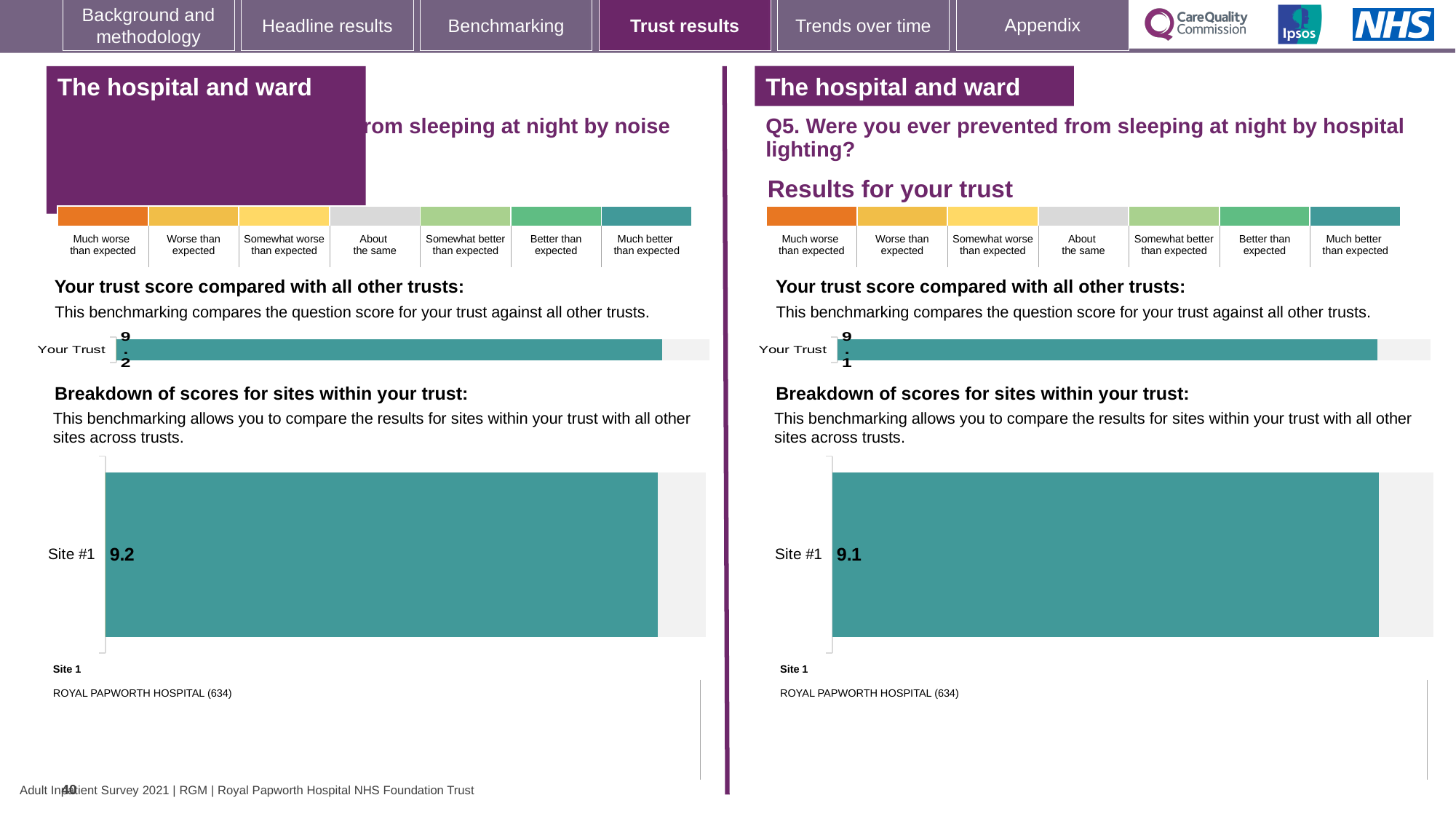
How many sites are plotted in the left 'Breakdown of scores for sites within your trust' chart? 1 On the left half of the slide, what is the 'Your Trust' score shown in the trust benchmarking bar chart? 9.2 On the right half of the slide (Q5, hospital lighting), what is the 'Your Trust' score shown in the trust benchmarking bar chart? 9.1 What type of chart is used to show the 'Your Trust' score on each half of the slide? Bar chart In the right 'Breakdown of scores for sites within your trust' chart (Q5, hospital lighting), what is the score for Site #1? 9.1 Which is larger: the 'Your Trust' score on the left half of the slide or the 'Your Trust' score on the right half (Q5, hospital lighting)? Left (9.2) How many sites are plotted in the right 'Breakdown of scores for sites within your trust' chart? 1 In the left 'Breakdown of scores for sites within your trust' chart, what is the score for Site #1? 9.2 Which hospital is listed as Site 1 beneath the breakdown charts? ROYAL PAPWORTH HOSPITAL (634) What type of chart is used in the 'Breakdown of scores for sites within your trust' sections? Bar chart According to the colour key, which benchmarking category does the teal colour of the bars correspond to? Much better than expected What is the difference between the Site #1 score in the left breakdown chart and the Site #1 score in the right breakdown chart? 0.1